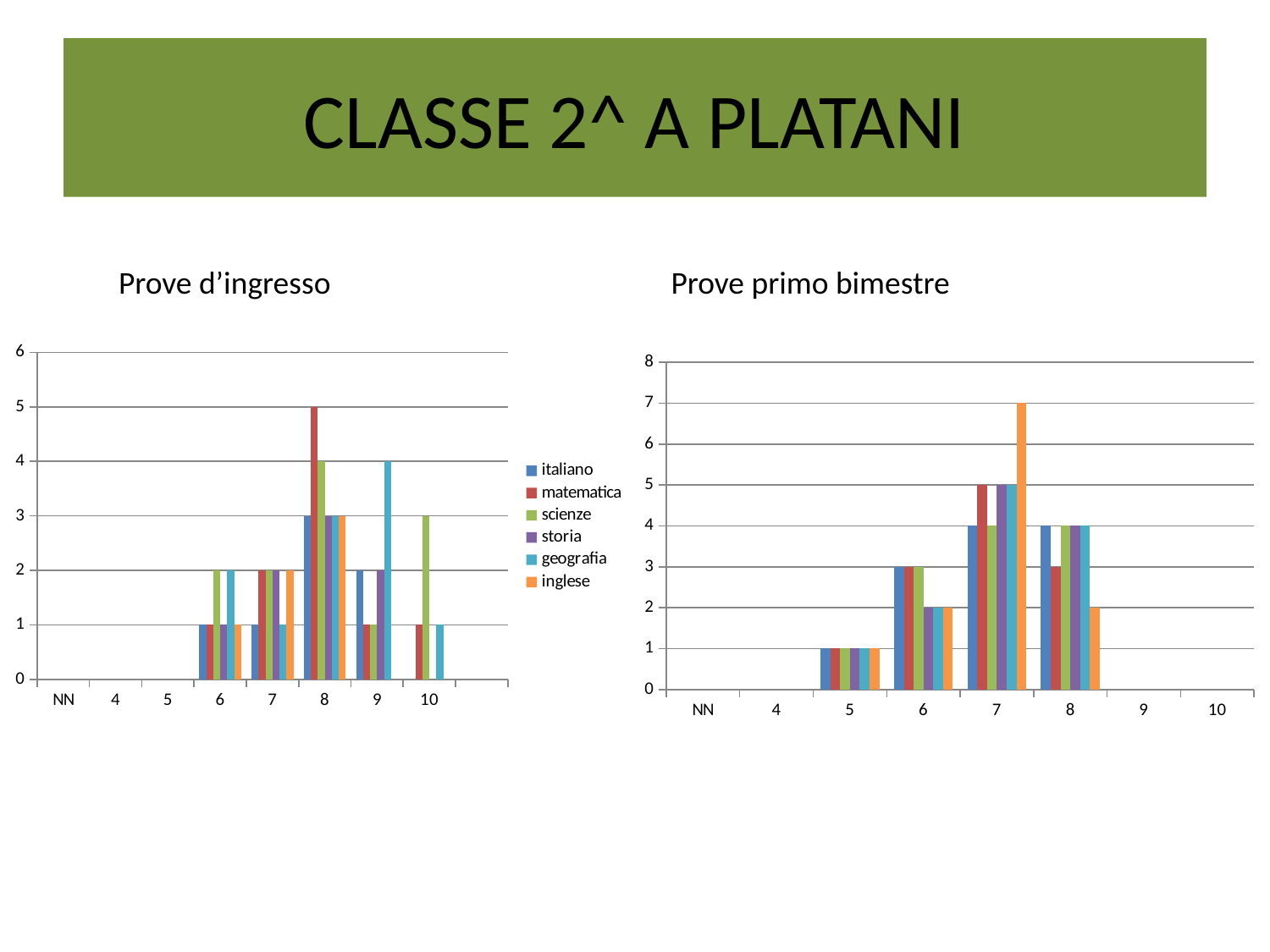
In the 'Prove primo bimestre' chart, is the value for inglese at category 7 greater or less than 6? greater In the 'Prove primo bimestre' chart, what is the value for italiano at category 6? 3 In the 'Prove d'ingresso' chart, what is the value for matematica at category 8? 5 How many categories are shown on the x axis of the 'Prove primo bimestre' chart? 8 In the 'Prove primo bimestre' chart, what is the highest value reached by any bar? 7 In the 'Prove primo bimestre' chart, what is the difference between the inglese bar and the italiano bar at category 7? 3 How many series does the legend of the 'Prove d'ingresso' chart list? 6 In the 'Prove d'ingresso' chart, what is the value for geografia at category 9? 4 In the 'Prove d'ingresso' chart, which is larger at category 10: the scienze bar or the matematica bar? scienze What kind of chart is the 'Prove d'ingresso' chart? bar chart In the 'Prove d'ingresso' chart, which series has the tallest bar, and at which category? matematica, at 8 In the 'Prove primo bimestre' chart, what is the value for inglese at category 7? 7